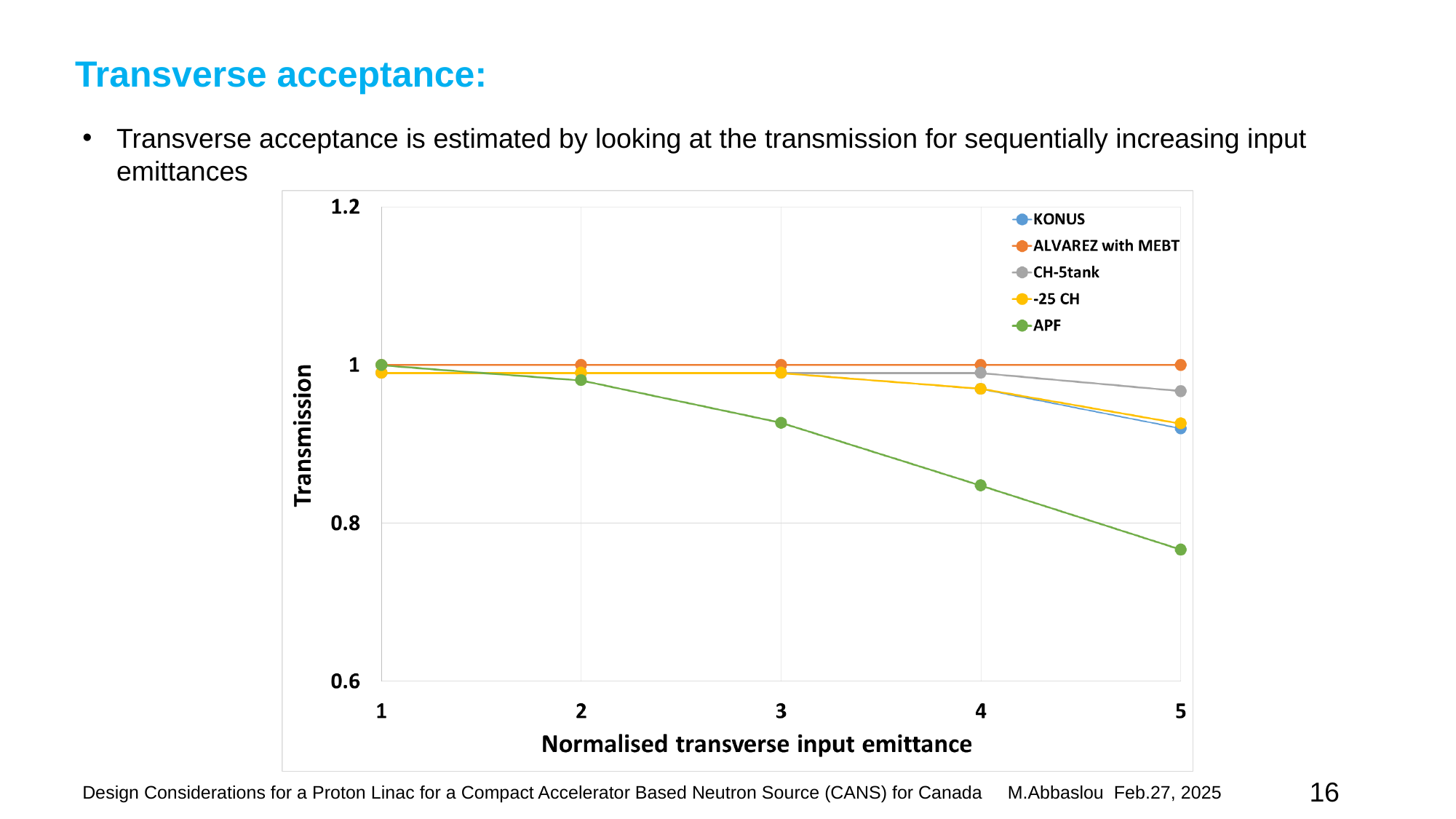
What is the title of the y axis? Transmission At a normalised transverse input emittance of 4, which has the larger transmission, CH-5tank or APF? CH-5tank How many series does the legend list? 5 What kind of chart is shown on the slide? line chart Does the transmission for APF rise or fall as the normalised transverse input emittance increases? fall Is the transmission for APF at a normalised transverse input emittance of 4 greater or less than 0.8? greater At a normalised transverse input emittance of 5, which has the larger transmission, APF or ALVAREZ with MEBT? ALVAREZ with MEBT Is the transmission for APF at a normalised transverse input emittance of 5 greater or less than 0.8? less How many normalised transverse input emittance values are plotted along the x axis? 5 Which series has the highest transmission at a normalised transverse input emittance of 5? ALVAREZ with MEBT What is the title of the x axis? Normalised transverse input emittance Which series has the lowest transmission at a normalised transverse input emittance of 5? APF